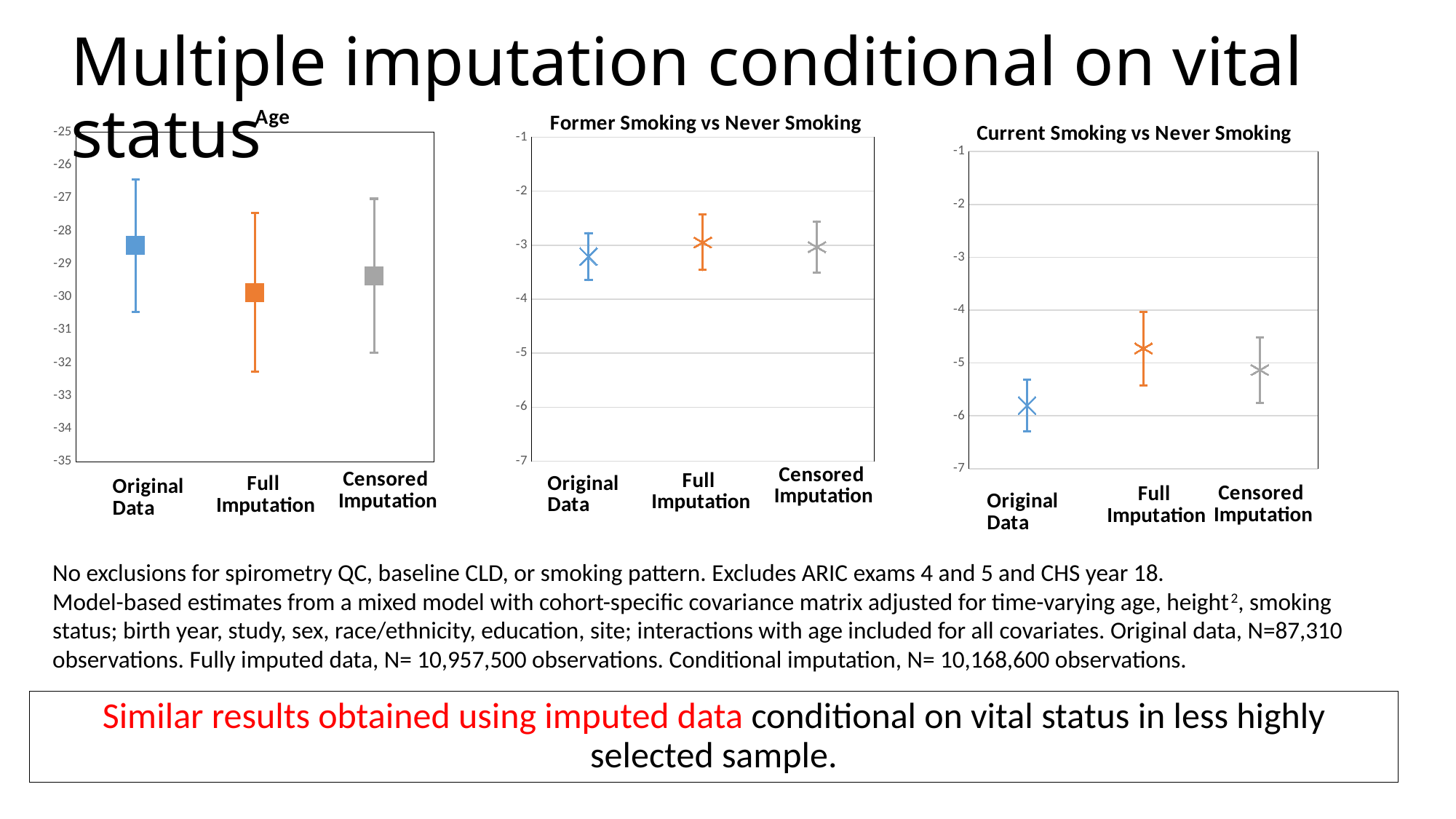
In the Age chart, how many categories are plotted on the x axis? 3 In the Former Smoking vs Never Smoking chart, how many categories are plotted? 3 In the Current Smoking vs Never Smoking chart, is the value for Full Imputation greater or less than -5? greater What is the title of the middle chart on the slide? Former Smoking vs Never Smoking In the Age chart, which category has the highest plotted value? Original Data In the Current Smoking vs Never Smoking chart, which category has the lowest plotted value? Original Data In the Age chart, is the value for Original Data greater or less than -29? greater In the Current Smoking vs Never Smoking chart, which is larger, the value for Full Imputation or the value for Original Data? Full Imputation In the Former Smoking vs Never Smoking chart, is the value for Original Data greater or less than -3? less In the Current Smoking vs Never Smoking chart, which category has the highest plotted value? Full Imputation